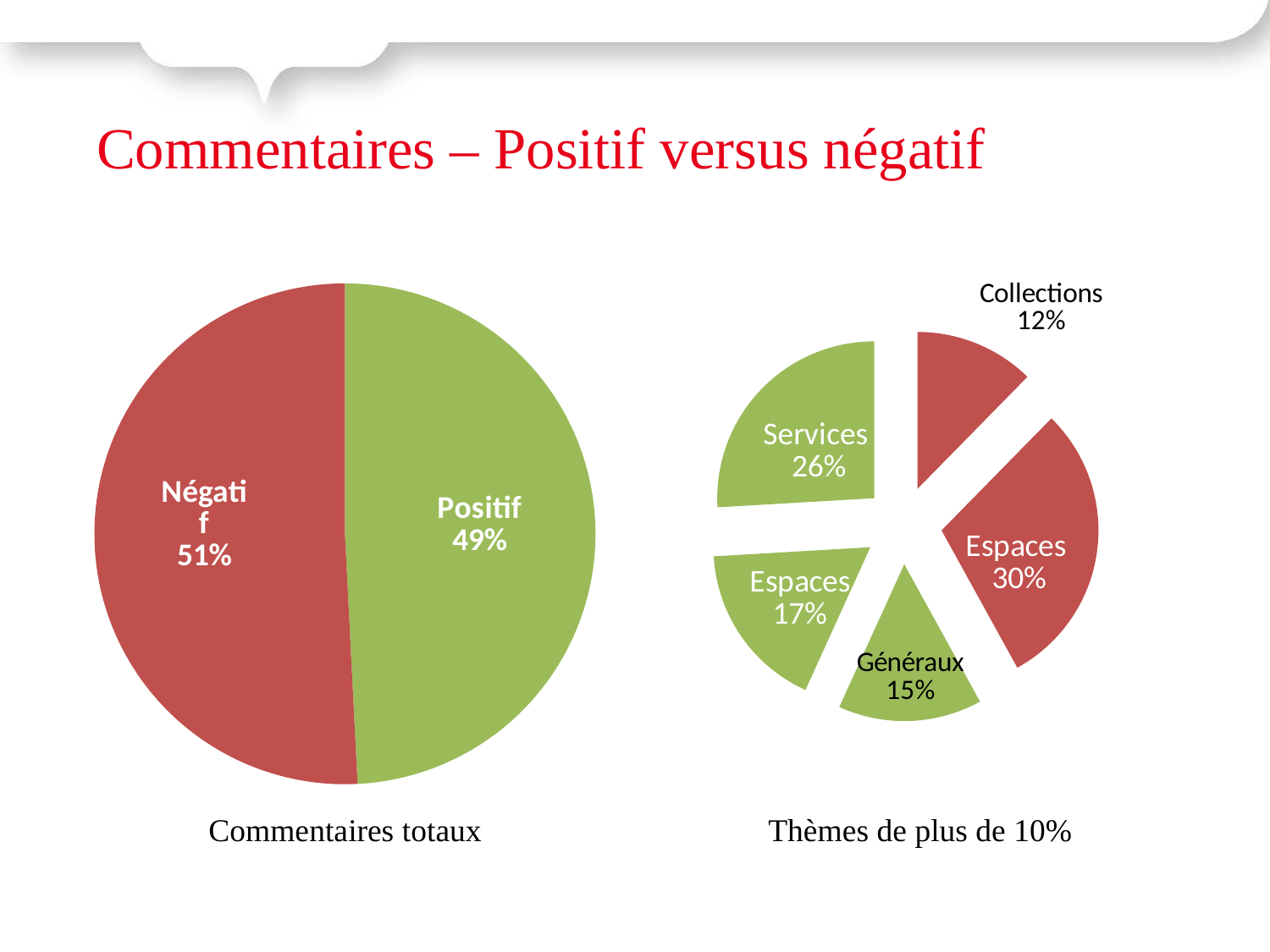
In the left chart (Commentaires totaux), what percentage of comments are Négatif? 51% What kind of chart is the left chart (Commentaires totaux)? Pie chart How many slices does the right chart (Thèmes de plus de 10%) have? 5 In the left chart (Commentaires totaux), what is the difference in percentage points between the Négatif and Positif slices? 2 percentage points In the right chart (Thèmes de plus de 10%), what percentage is shown for Généraux? 15% In the left chart (Commentaires totaux), which slice is larger, Négatif or Positif? Négatif In the right chart (Thèmes de plus de 10%), which slice has the largest share? Espaces (30%) In the right chart (Thèmes de plus de 10%), what percentage is shown for Collections? 12% In the left chart (Commentaires totaux), what percentage of comments are Positif? 49% In the right chart (Thèmes de plus de 10%), which slice has the smallest share? Collections (12%) In the right chart (Thèmes de plus de 10%), what is the difference in percentage points between the red Espaces slice (30%) and the Services slice? 4 percentage points In the right chart (Thèmes de plus de 10%), what percentage is shown for Services? 26%